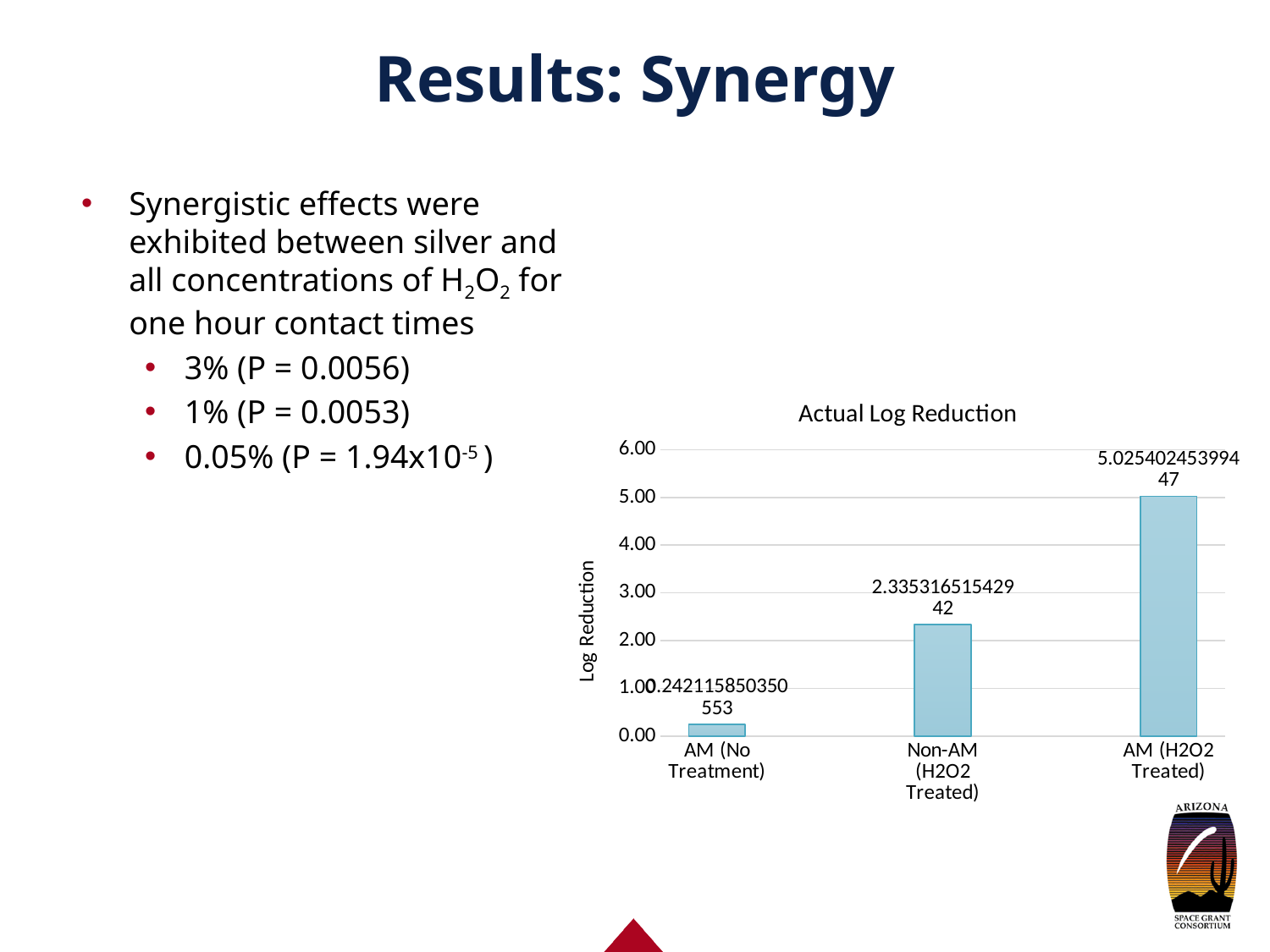
What is the title of the chart? Actual Log Reduction Which category has the lowest log reduction? AM (No Treatment) How many categories are plotted in the chart? 3 Which has a larger log reduction, Non-AM (H2O2 Treated) or AM (H2O2 Treated)? AM (H2O2 Treated) Is the log reduction for Non-AM (H2O2 Treated) greater or less than 2.00? greater What type of chart is shown on the slide? bar chart What is the log reduction value for AM (H2O2 Treated)? 5.02540245399447 What is the log reduction value for Non-AM (H2O2 Treated)? 2.33531651542942 What is the log reduction value for AM (No Treatment)? 0.242115850350553 What is the difference in log reduction between AM (H2O2 Treated) and Non-AM (H2O2 Treated)? 2.69008593856505 Which category has the highest log reduction? AM (H2O2 Treated) What is the y-axis label of the chart? Log Reduction